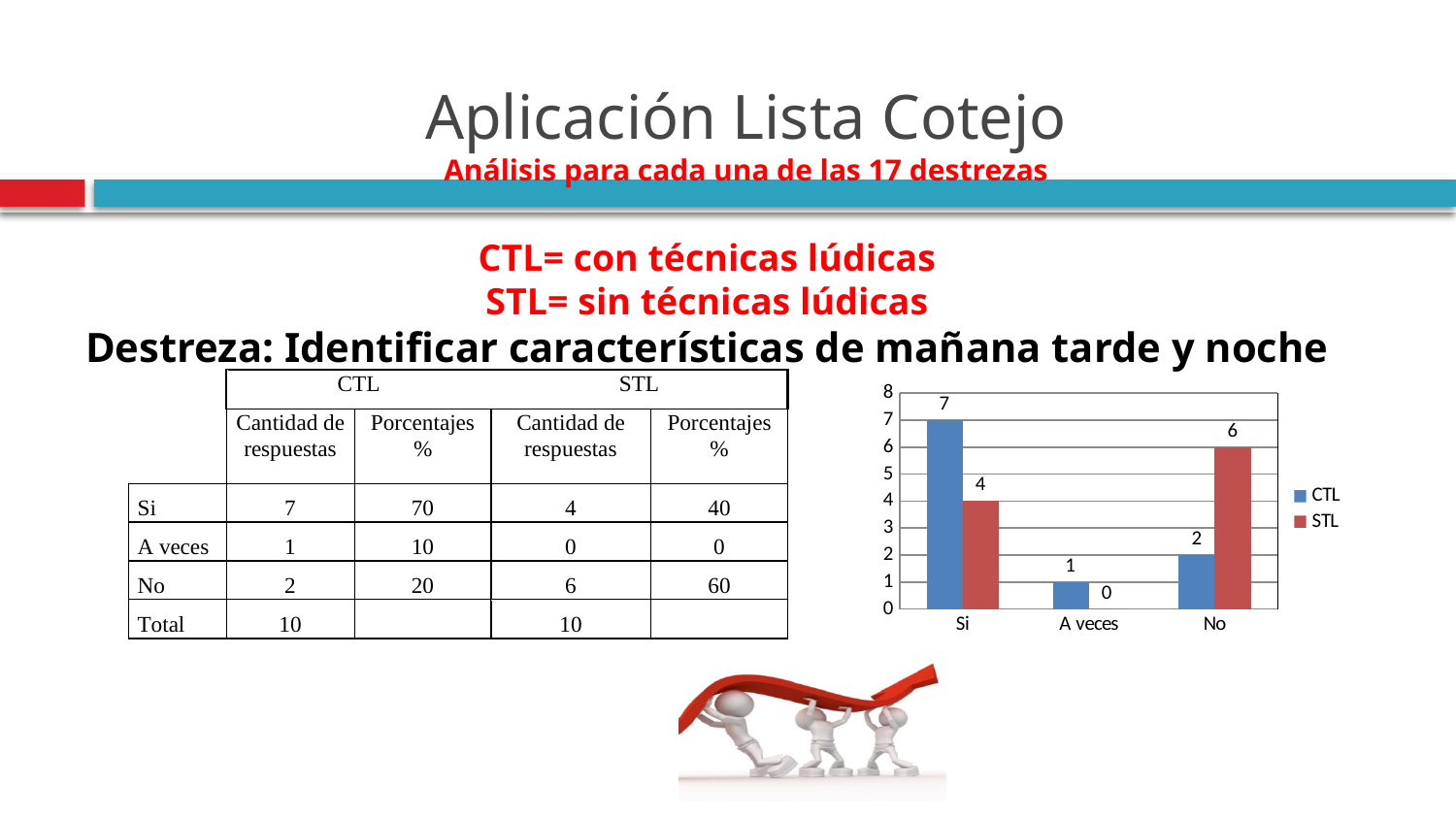
What kind of chart is shown on the slide? Bar chart What colour are the STL bars in the chart? Red What is the CTL value for Si in the chart? 7 What is the STL value for No in the chart? 6 How many categories are shown on the x axis of the chart? 3 Which category has the lowest STL value in the chart? A veces How many series does the chart legend list? 2 Which is larger for No: the CTL value or the STL value? STL What is the difference between the CTL and STL values for Si? 3 What is the STL value for A veces in the chart? 0 Which category has the highest CTL value in the chart? Si What is the CTL value for No in the chart? 2